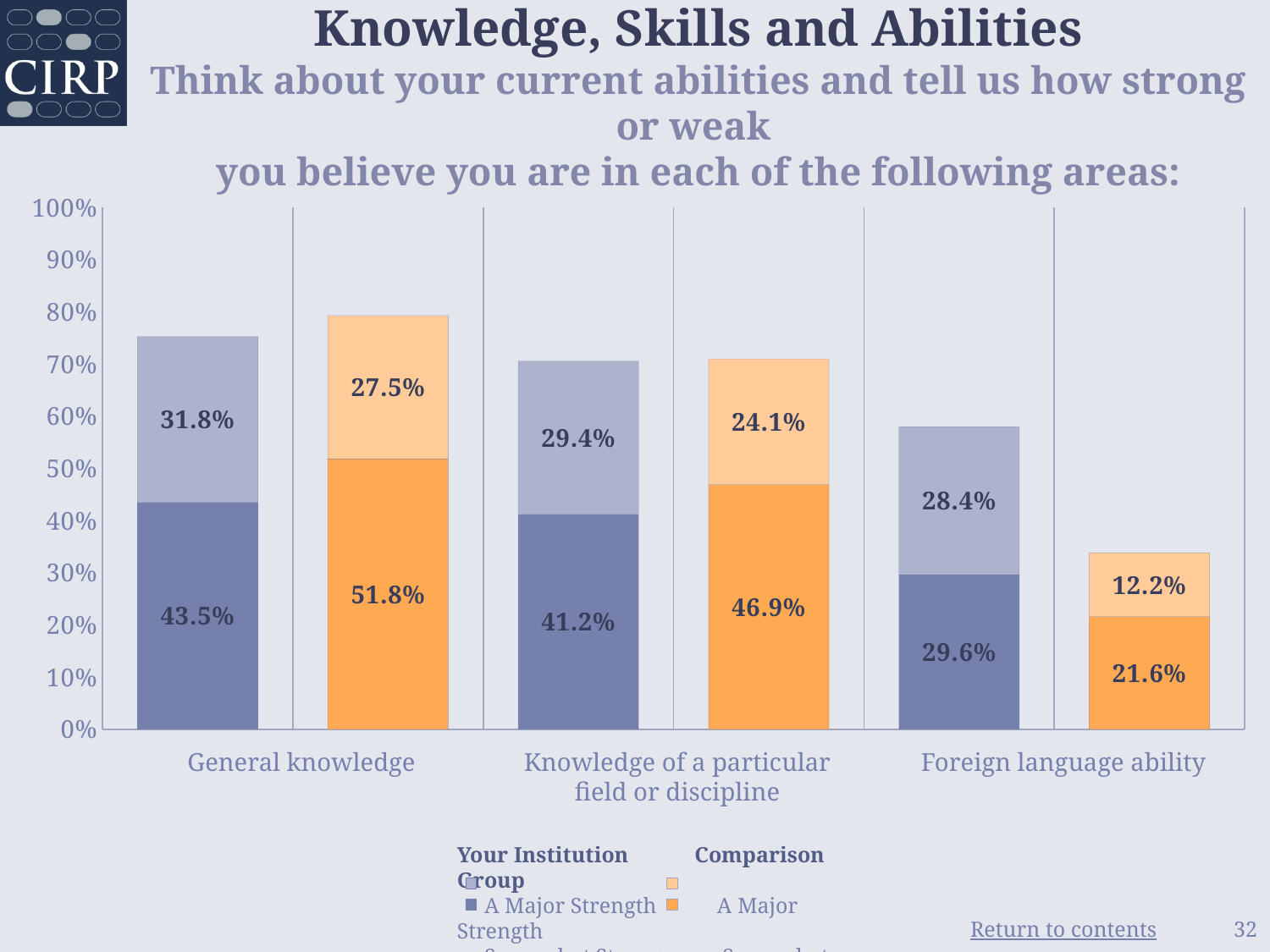
For Foreign language ability, which is larger: Your Institution's 'A Major Strength' value or the Comparison Group's 'A Major Strength' value? Your Institution What type of chart is shown on the slide? stacked bar chart Which category has the lowest 'A Major Strength' value for Your Institution? Foreign language ability Is the total of the Comparison Group bar for Foreign language ability greater or less than 40%? less What is the value of the top (lighter) segment of the Comparison Group bar for Knowledge of a particular field or discipline? 24.1% What is the 'A Major Strength' value for the Comparison Group in Foreign language ability? 21.6% Which category has the highest 'A Major Strength' value for the Comparison Group? General knowledge What is the 'A Major Strength' value for Your Institution in General knowledge? 43.5% What is the difference between the Comparison Group's and Your Institution's 'A Major Strength' values for General knowledge? 8.3 percentage points What is the total height of the Comparison Group stacked bar for General knowledge? 79.3% What is the total height of the Your Institution stacked bar for Foreign language ability? 58.0% How many categories are shown along the x axis? 3